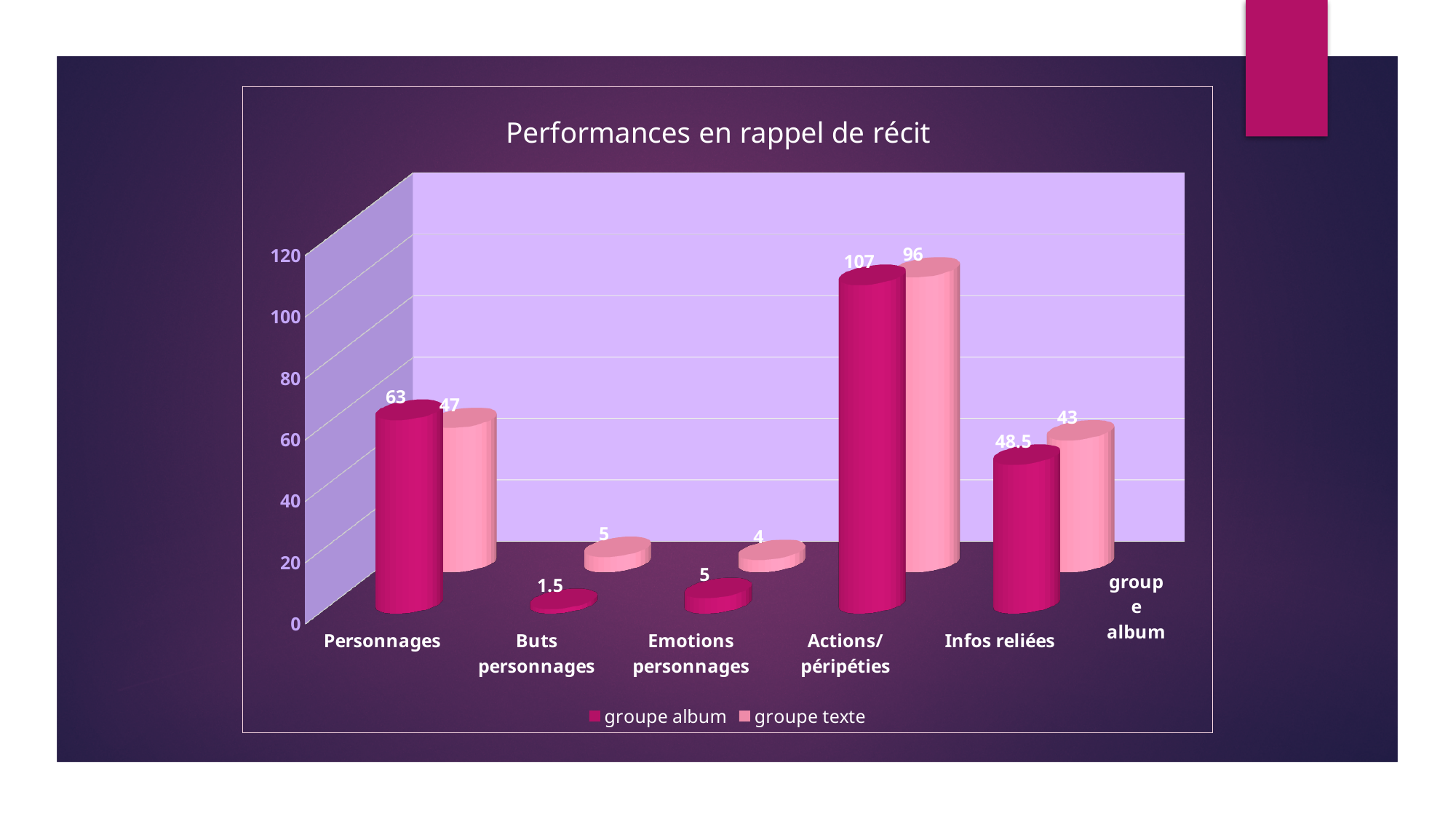
In the Buts personnages category, which series has the larger value, groupe album or groupe texte? groupe texte What is the value for groupe texte in the Actions/péripéties category? 96 How many series does the legend list? 2 What is the title of the chart? Performances en rappel de récit How many categories are shown on the x axis? 5 What is the value for groupe album in the Buts personnages category? 1.5 Which category has the highest value for groupe album? Actions/péripéties What kind of chart is shown on the slide? bar chart What is the value for groupe texte in the Infos reliées category? 43 What is the difference between groupe album and groupe texte in the Personnages category? 16 What is the value for groupe album in the Personnages category? 63 Which category has the lowest value for groupe texte? Emotions personnages